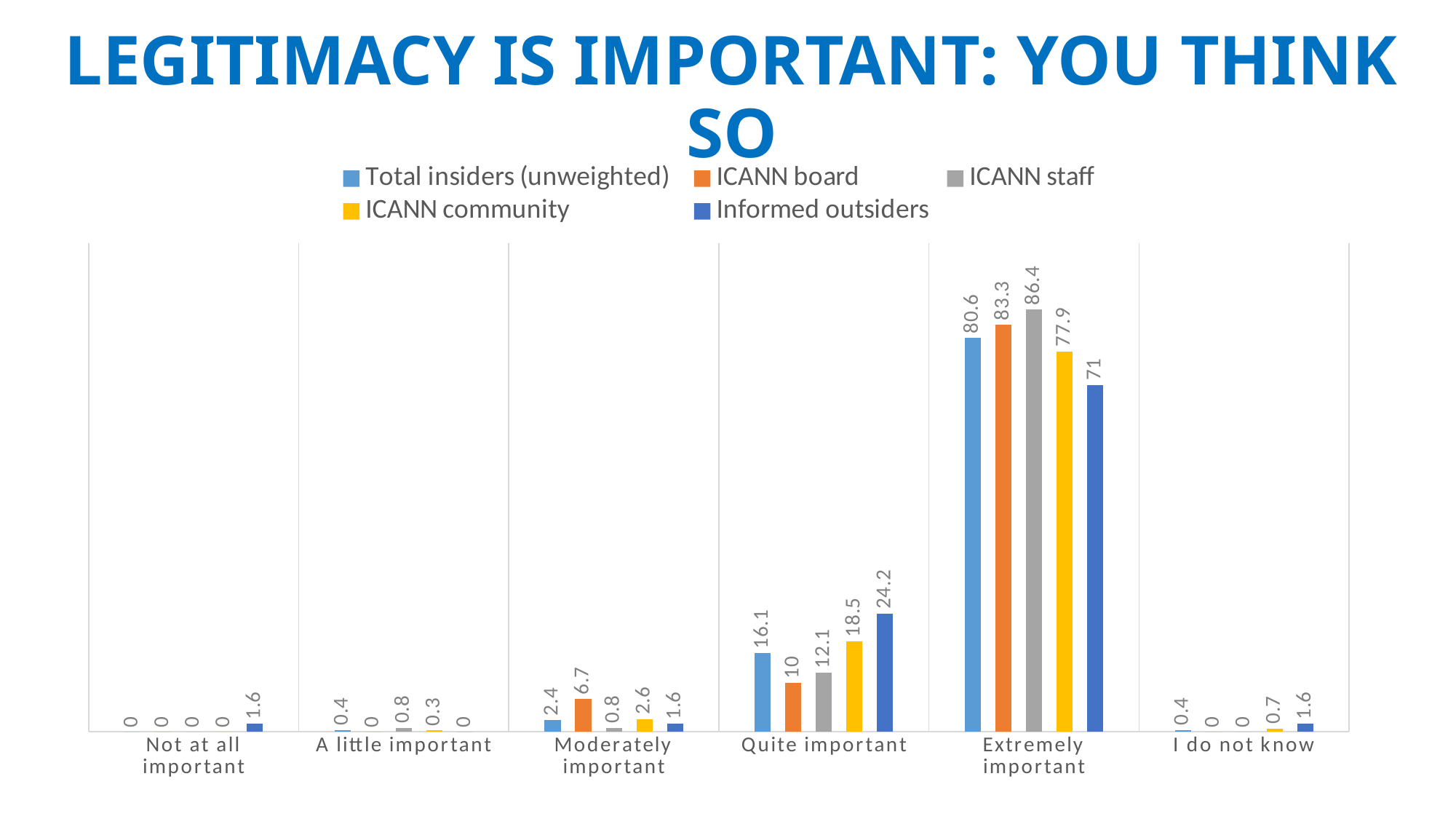
What is the value for ICANN staff in the Extremely important category? 86.4 Which category has the highest value for Total insiders (unweighted)? Extremely important What kind of chart is shown on the slide? Bar chart Which series has the highest value in the Extremely important category? ICANN staff How many series does the legend list? 5 What is the value for Total insiders (unweighted) in the I do not know category? 0.4 What is the value for ICANN board in the Moderately important category? 6.7 In the Quite important category, which is larger: the value for ICANN community or the value for ICANN board? ICANN community How many categories are shown on the x axis? 6 What is the difference between the ICANN board and ICANN community values in the Extremely important category? 5.4 What is the value for Informed outsiders in the Quite important category? 24.2 Which series has the lowest value in the Extremely important category? Informed outsiders